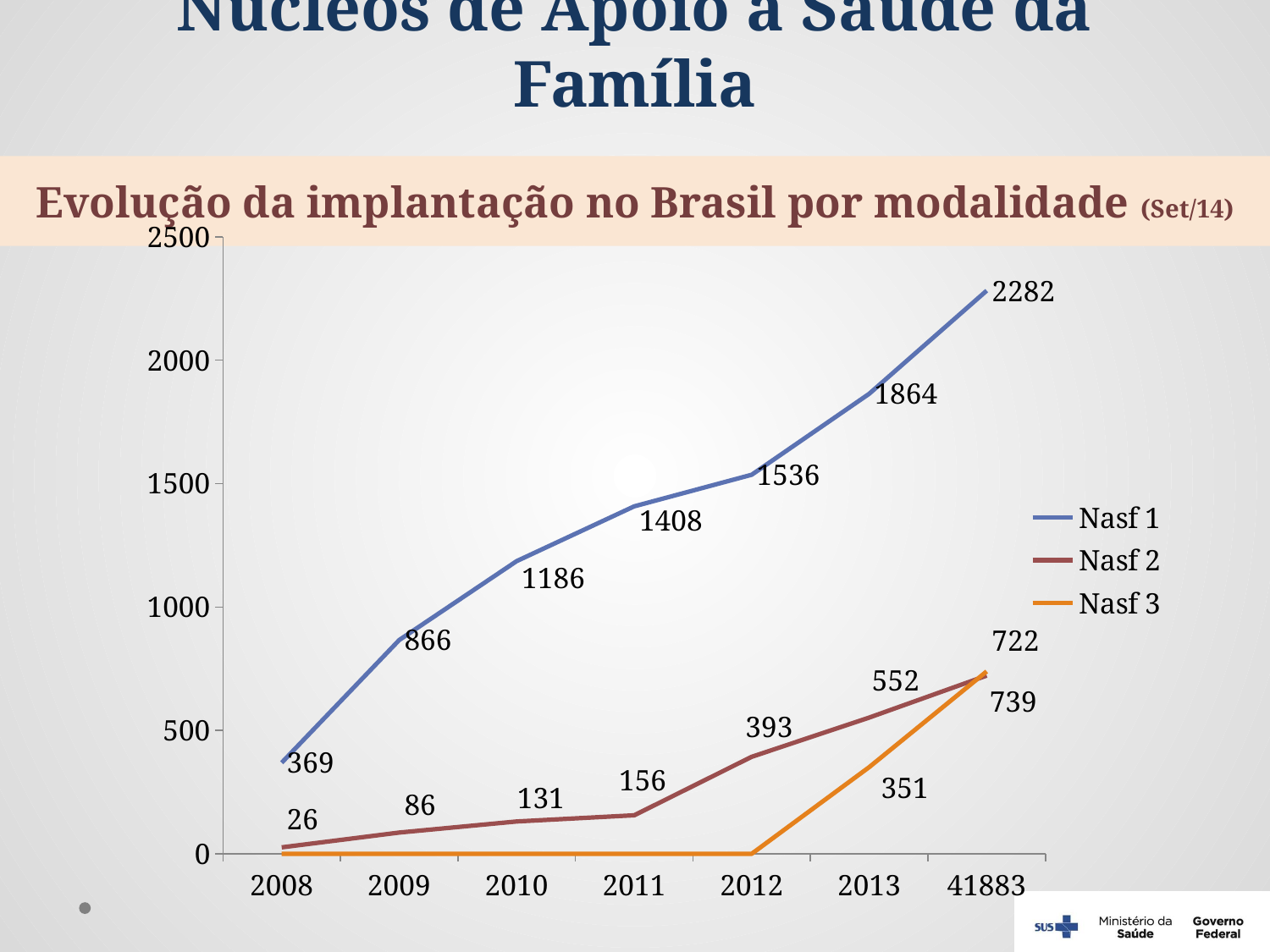
What is the value for Nasf 1 in 2013? 1864 Does the Nasf 1 line rise or fall from 2008 to the last point? rises What is the value for Nasf 2 in 2009? 86 What is the value for Nasf 2 in 2012? 393 What is the value for Nasf 1 in 2008? 369 How many series does the legend list? 3 What is the highest value shown for Nasf 1? 2282 What kind of chart is shown on the slide? line chart In 2011, which series has the larger value, Nasf 1 or Nasf 2? Nasf 1 What is the value for Nasf 3 in 2013? 351 How many points are shown along the x axis? 7 By how much did Nasf 1 increase from 2012 to 2013? 328